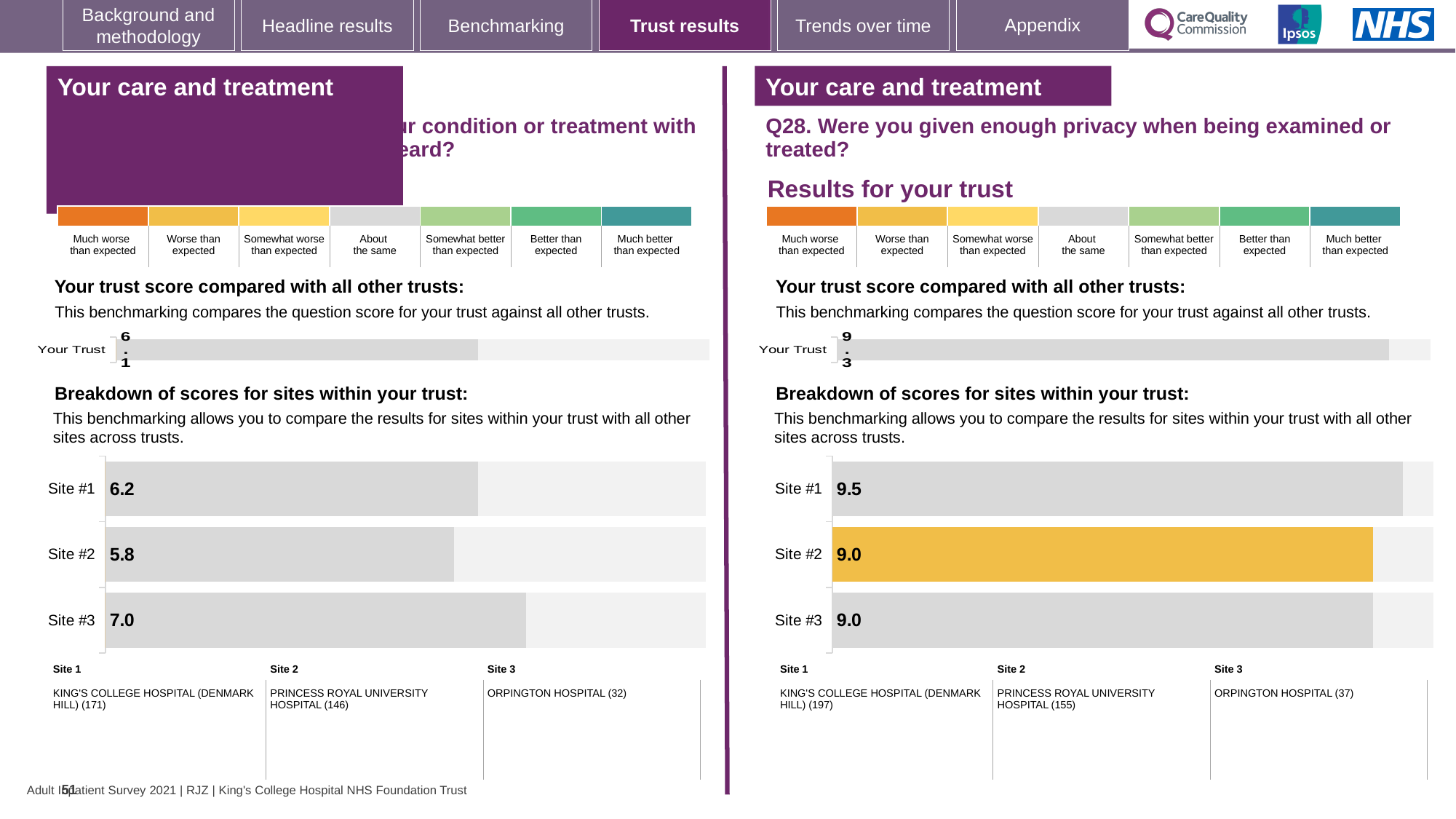
In the 'Your trust score compared with all other trusts' chart for Q28 on the right, what is the score for Your Trust? 9.3 In the Q28 site breakdown chart on the right, what is the difference between the scores for Site #1 and Site #2? 0.5 In the site breakdown chart on the left side of the slide, which site has the lowest score? Site #2 In the Q28 site breakdown chart on the right, what is the score for Site #2? 9.0 How many sites are shown in the Q28 site breakdown chart on the right? 3 In the Q28 site breakdown chart on the right, which site has the highest score? Site #1 In the Q28 site breakdown chart on the right, what is the score for Site #1? 9.5 In the site breakdown chart on the left side of the slide, what is the score for Site #3? 7.0 In the site breakdown chart on the left side of the slide, what is the score for Site #2? 5.8 In the site breakdown chart on the left side of the slide, which site has the highest score? Site #3 In the site breakdown chart on the left side of the slide, what is the difference between the scores for Site #3 and Site #2? 1.2 What type of chart is used for the site breakdown on the right side of the slide? Bar chart